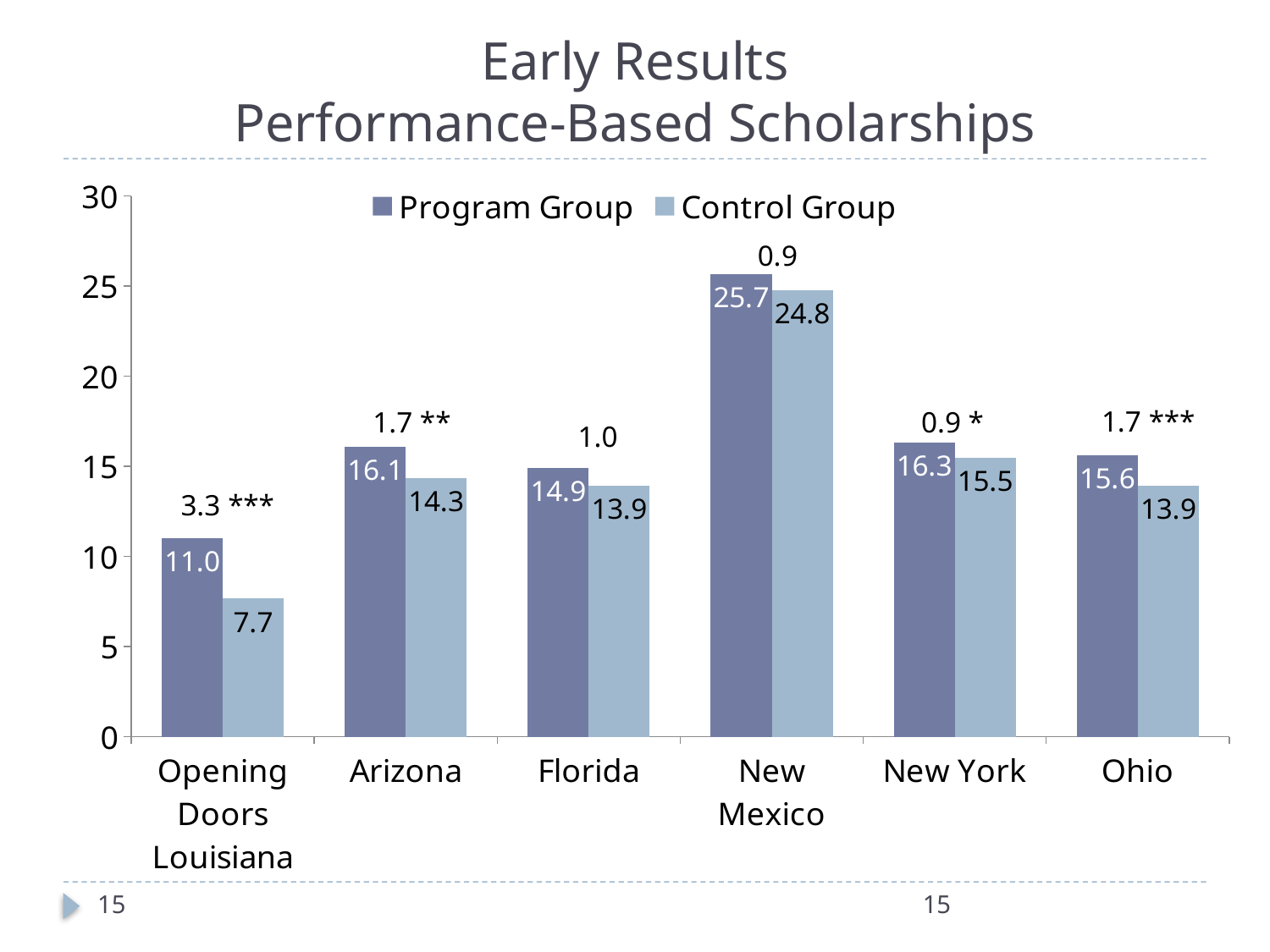
Which is larger for New York: the Program Group value or the Control Group value? Program Group What kind of chart is shown on the slide? bar chart Which category has the lowest Control Group value? Opening Doors Louisiana What is the Program Group value for Ohio? 15.6 What is the title of the chart? Early Results Performance-Based Scholarships How many series does the legend list? 2 Which category has the highest Program Group value? New Mexico Is the Control Group value for Florida greater or less than 15? less What is the Program Group value for New Mexico? 25.7 What is the Control Group value for Opening Doors Louisiana? 7.7 What is the difference between the Program Group and Control Group values for Arizona? 1.8 How many categories are shown on the x axis? 6